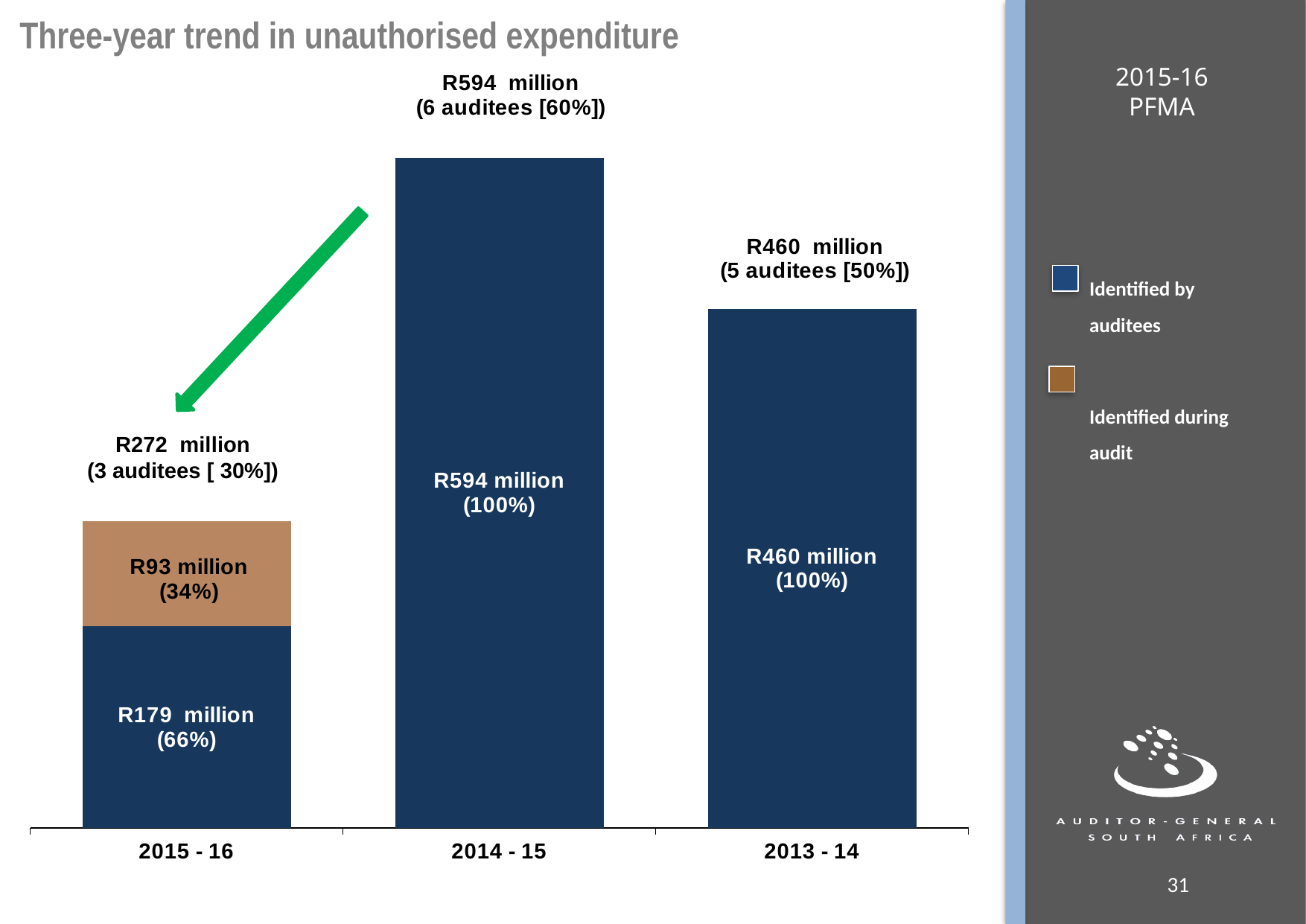
How many years are shown on the x axis? 3 What kind of chart is shown on the slide? Stacked bar chart What is the value for 'Identified during audit' in 2015 - 16? R93 million What percentage of the 2015 - 16 total was identified during audit? 34% What is the difference between the 2014 - 15 and 2013 - 14 totals? R134 million Which year has the highest unauthorised expenditure? 2014 - 15 Which is larger, the 2013 - 14 total or the 2015 - 16 total? 2013 - 14 What is the value for 'Identified by auditees' in 2015 - 16? R179 million What is the total unauthorised expenditure shown for 2015 - 16? R272 million Which year has the lowest unauthorised expenditure? 2015 - 16 What is the unauthorised expenditure shown for 2014 - 15? R594 million How many series does the legend list? 2